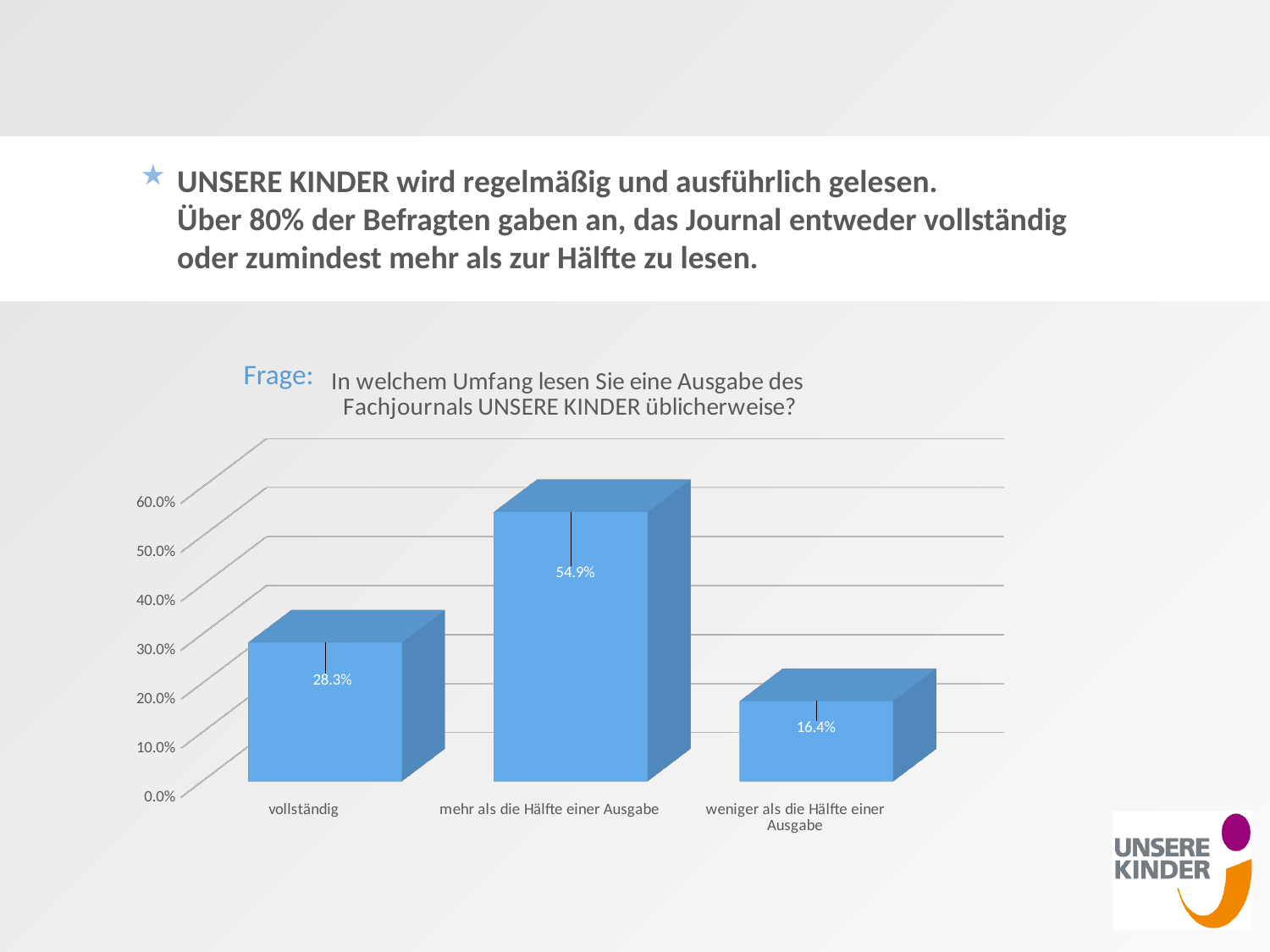
What kind of chart is shown on the slide? bar chart Which category has the lowest value? weniger als die Hälfte einer Ausgabe What is the difference between the values for "mehr als die Hälfte einer Ausgabe" and "vollständig"? 26.6% What is the difference between the values for "vollständig" and "weniger als die Hälfte einer Ausgabe"? 11.9% Is the value for "mehr als die Hälfte einer Ausgabe" greater or less than 50.0%? greater How many categories are shown on the x axis? 3 What is the value for "weniger als die Hälfte einer Ausgabe"? 16.4% Which is larger, the value for "vollständig" or for "weniger als die Hälfte einer Ausgabe"? vollständig What is the value for "mehr als die Hälfte einer Ausgabe"? 54.9% What is the value for "vollständig"? 28.3% What question does the chart title ask? In welchem Umfang lesen Sie eine Ausgabe des Fachjournals UNSERE KINDER üblicherweise? Which category has the highest value? mehr als die Hälfte einer Ausgabe